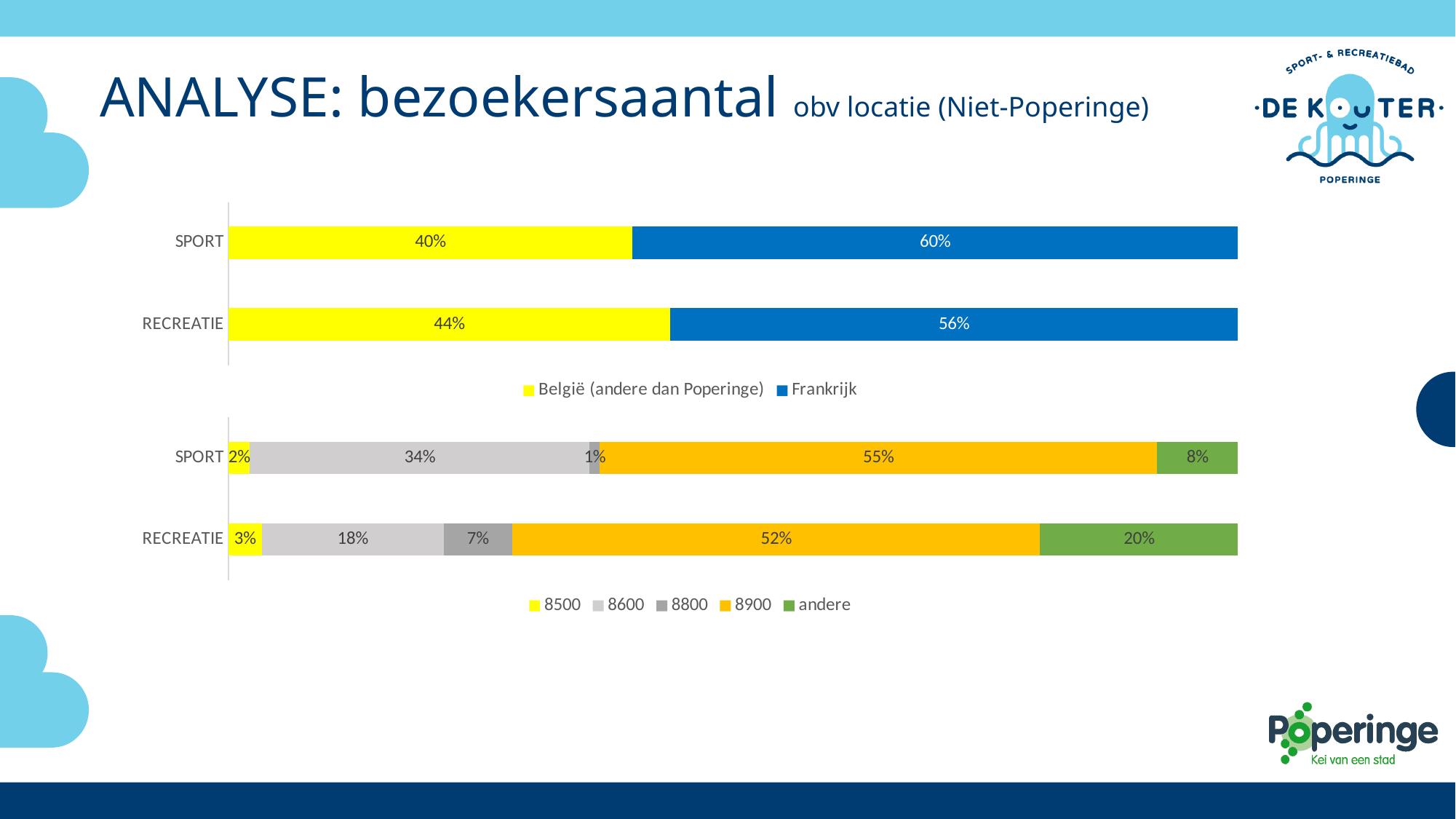
How many series does the legend of the top chart list? 2 What kind of chart is the bottom chart? Stacked bar chart How many series does the legend of the bottom chart list? 5 In the bottom chart, which series has the largest share of the SPORT bar? 8900 In the top chart, what is the value for België (andere dan Poperinge) in the RECREATIE bar? 44% In the bottom chart, what is the value for 8900 in the SPORT bar? 55% In the bottom chart, what is the value for andere in the RECREATIE bar? 20% In the top chart, which category has the higher value for Frankrijk, SPORT or RECREATIE? SPORT In the top chart, what is the difference between the Frankrijk and België (andere dan Poperinge) values for SPORT? 20% In the top chart, what is the value for Frankrijk in the SPORT bar? 60% In the bottom chart, what is the value for 8600 in the RECREATIE bar? 18% In the bottom chart, what is the difference between the andere values for RECREATIE and SPORT? 12%